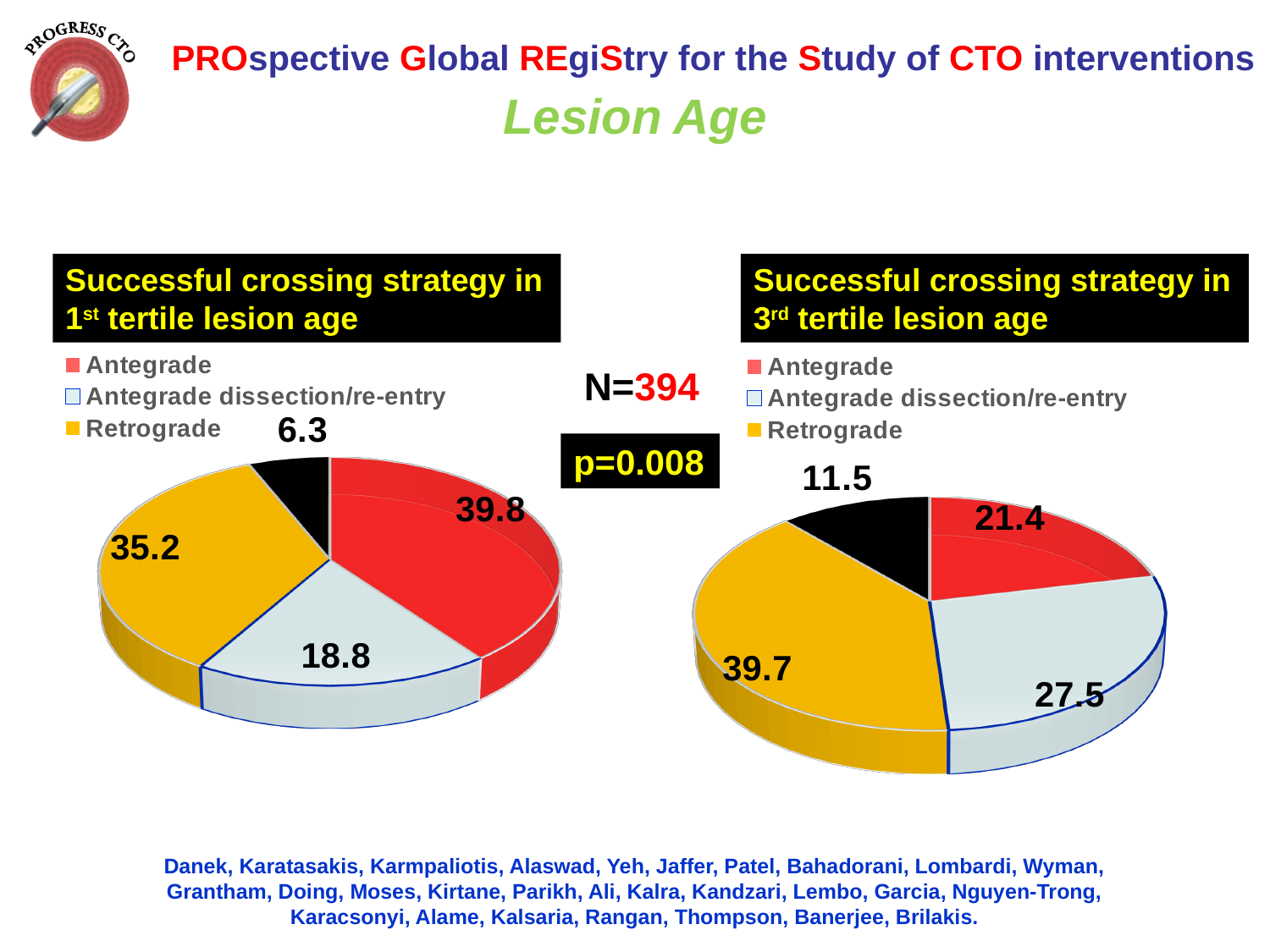
In the 'Successful crossing strategy in 1st tertile lesion age' chart, which legend category has the largest slice? Antegrade How many entries does the legend of the 'Successful crossing strategy in 1st tertile lesion age' chart list? 3 In the 'Successful crossing strategy in 1st tertile lesion age' chart, what is the value for Retrograde? 35.2 In the 'Successful crossing strategy in 3rd tertile lesion age' chart, which legend category has the smallest slice? Antegrade In the 'Successful crossing strategy in 3rd tertile lesion age' chart, which legend category has the largest slice? Retrograde In the 'Successful crossing strategy in 3rd tertile lesion age' chart, what is the value for Retrograde? 39.7 In the 'Successful crossing strategy in 3rd tertile lesion age' chart, which is larger, Retrograde or Antegrade? Retrograde What type of chart is used for the 'Successful crossing strategy in 1st tertile lesion age' data? Pie chart How many slices does the 'Successful crossing strategy in 3rd tertile lesion age' pie chart have? 4 In the 'Successful crossing strategy in 1st tertile lesion age' chart, what is the value for Antegrade? 39.8 In the 'Successful crossing strategy in 3rd tertile lesion age' chart, what is the value for Antegrade dissection/re-entry? 27.5 In the 'Successful crossing strategy in 1st tertile lesion age' chart, what is the difference between the Antegrade and Antegrade dissection/re-entry values? 21.0